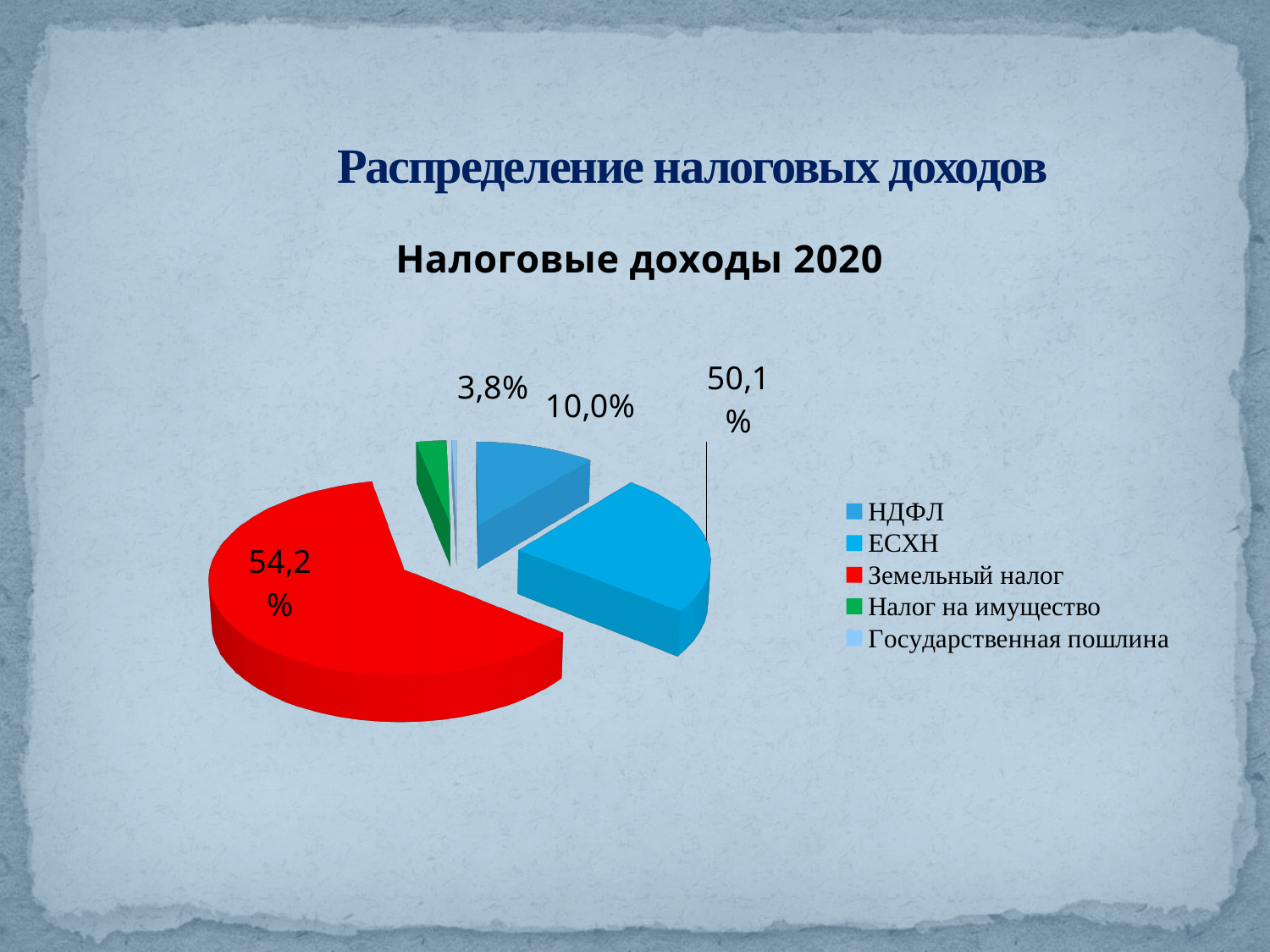
Which is larger, the slice for Налог на имущество or the slice for Государственная пошлина? Налог на имущество What percentage label is shown for НДФЛ? 10,0% What is the difference in percentage points between the labels for Земельный налог and Налог на имущество? 50,4 What is the title of the chart? Налоговые доходы 2020 How many categories does the legend of the pie chart list? 5 Which category has the largest slice of the pie? Земельный налог What percentage is shown for Налог на имущество? 3,8% What kind of chart is shown on the slide? pie chart Which category has the smallest slice of the pie? Государственная пошлина Which is larger, the slice for Земельный налог or the slice for НДФЛ? Земельный налог What percentage is shown for Земельный налог? 54,2% Which colour represents Земельный налог in the legend? red